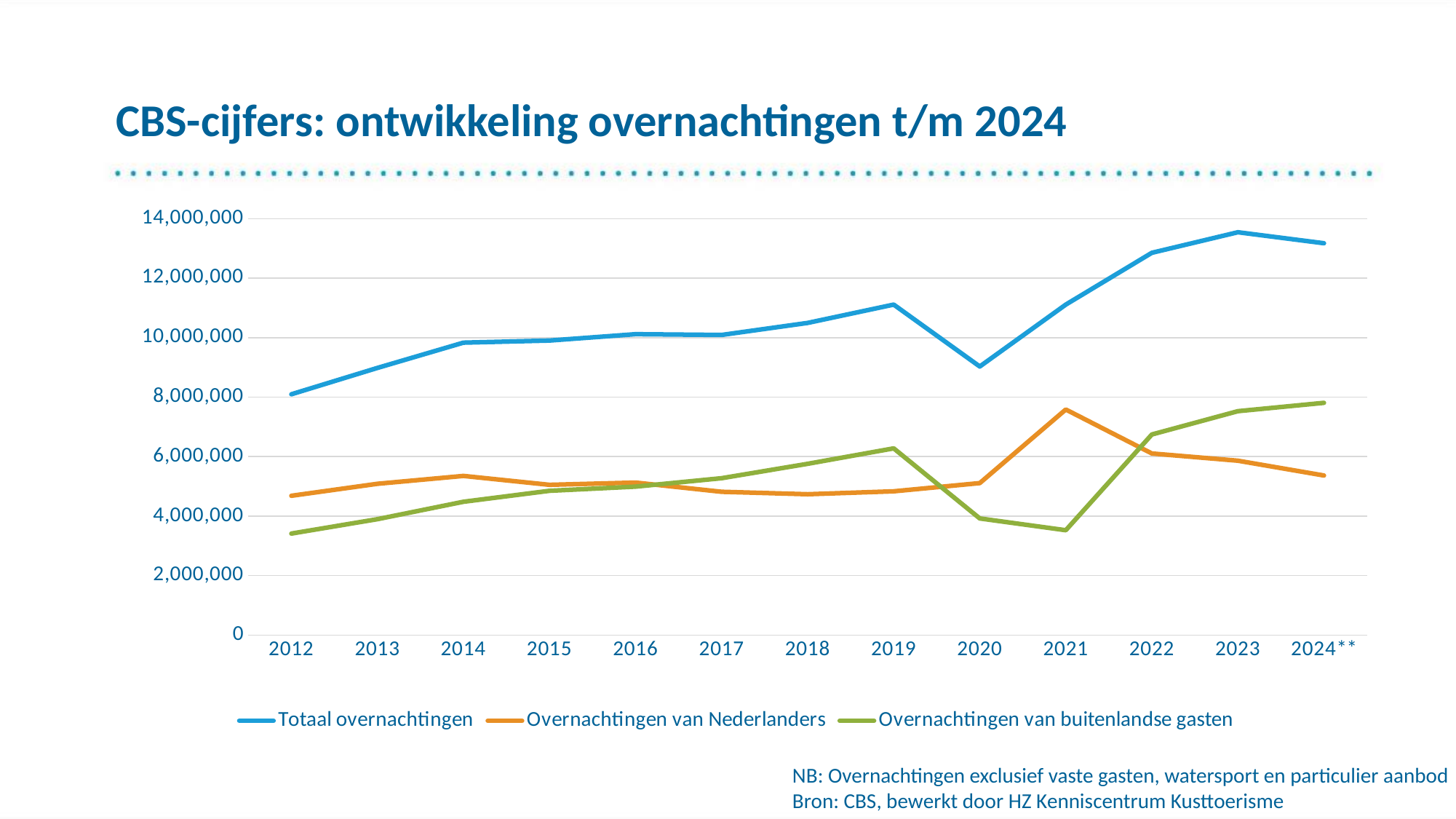
What kind of chart is shown on the slide? line chart Is the value for Totaal overnachtingen in 2020 greater or less than 10,000,000? less In which year is Overnachtingen van Nederlanders highest? 2021 In which year is Totaal overnachtingen highest? 2023 In which year is Overnachtingen van buitenlandse gasten highest? 2024** Does Overnachtingen van buitenlandse gasten rise or fall from 2021 to 2024**? rise In 2024**, which is larger: Overnachtingen van Nederlanders or Overnachtingen van buitenlandse gasten? Overnachtingen van buitenlandse gasten How many years are shown on the x axis? 13 How many series does the legend list? 3 Is the value for Totaal overnachtingen in 2023 greater or less than 12,000,000? greater In 2021, which is larger: Overnachtingen van Nederlanders or Overnachtingen van buitenlandse gasten? Overnachtingen van Nederlanders Is the value for Overnachtingen van buitenlandse gasten in 2021 greater or less than 4,000,000? less